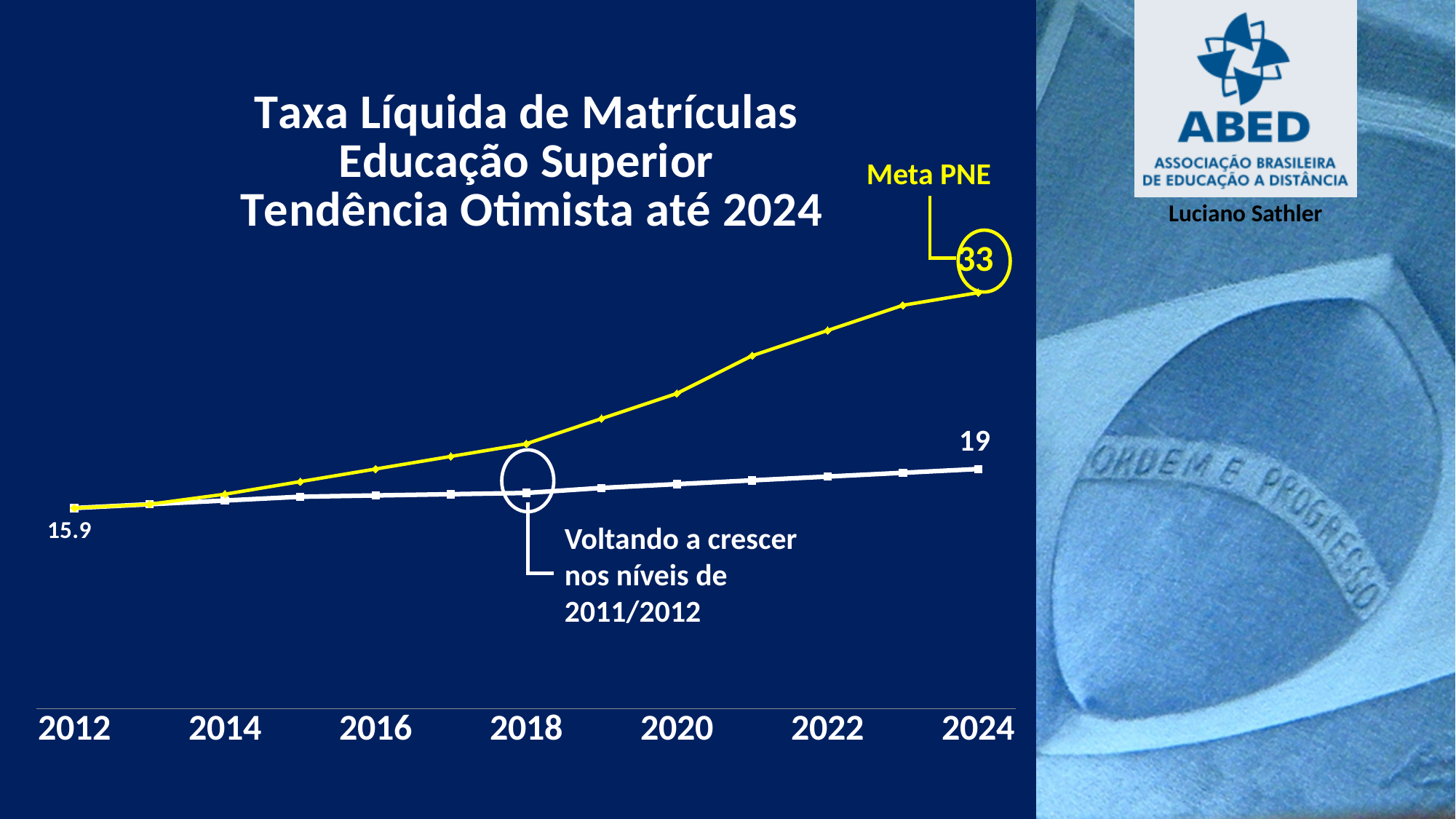
What kind of chart is shown on the slide? line chart What is the difference between the Meta PNE value and the white line value in 2024? 14 How many lines are plotted on the chart? 2 Do the values of the Meta PNE line rise or fall from 2012 to 2024? rise Which line is higher in 2024, the Meta PNE line or the white line? Meta PNE What value does the white line reach in 2024? 19 What is the first year shown on the x axis? 2012 What is the label of the yellow line? Meta PNE What is the value of the white line in 2012? 15.9 By how much does the white line increase from 2012 to 2024? 3.1 What value does the Meta PNE line reach in 2024? 33